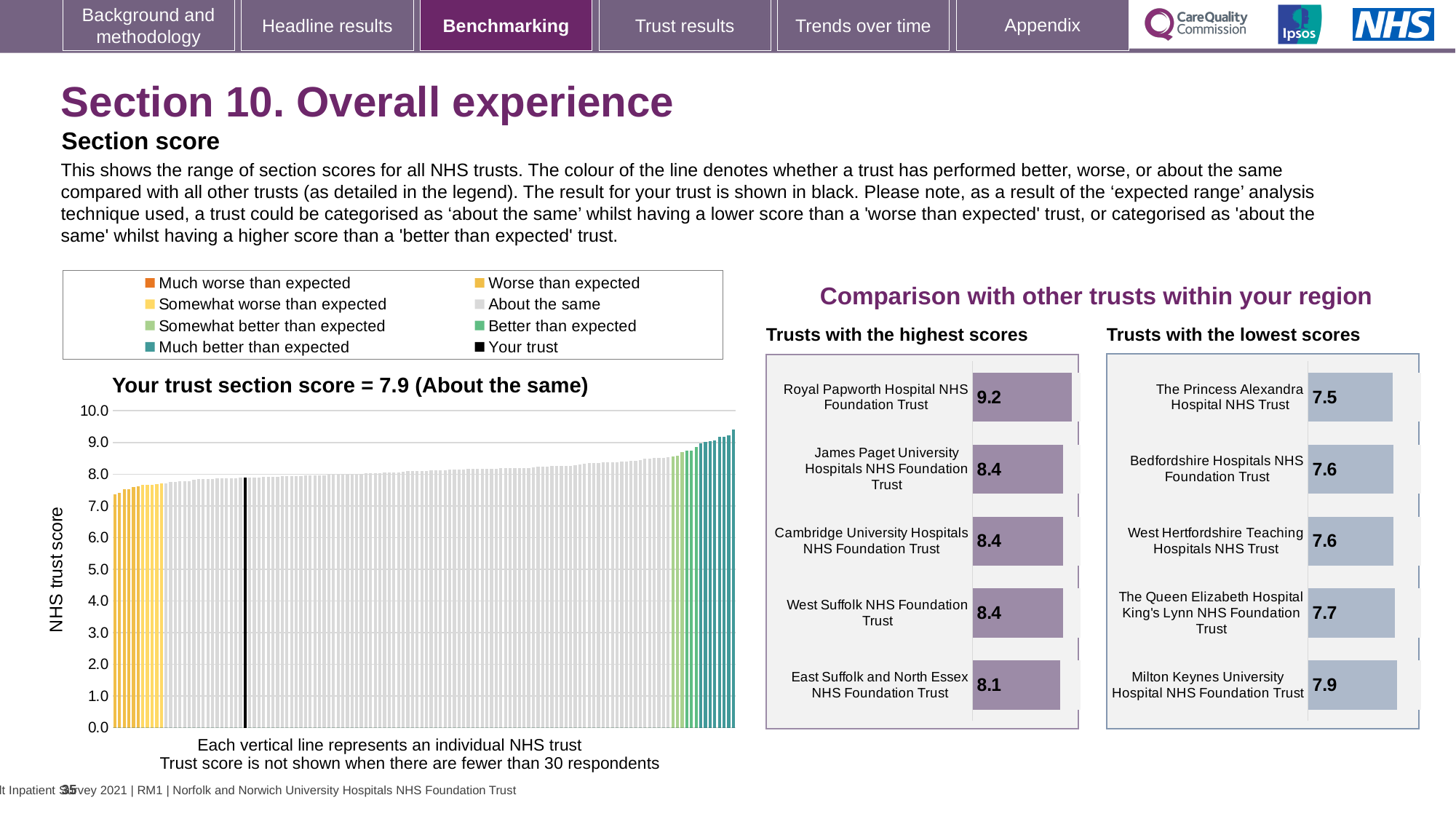
In the 'Trusts with the highest scores' chart, what is the score for Royal Papworth Hospital NHS Foundation Trust? 9.2 How many trusts are shown in the 'Trusts with the lowest scores' chart? 5 What is the y-axis label of the 'Your trust section score' chart? NHS trust score In the 'Trusts with the highest scores' chart, which trust has the lowest score? East Suffolk and North Essex NHS Foundation Trust In the 'Trusts with the lowest scores' chart, which trust has the lowest score? The Princess Alexandra Hospital NHS Trust In the 'Your trust section score' chart, do the trust scores rise or fall from left to right? rise In the 'Your trust section score' chart, is the value of the highest-scoring trust greater or less than 10.0? less In the 'Trusts with the highest scores' chart, what is the difference between the scores of Royal Papworth Hospital NHS Foundation Trust and East Suffolk and North Essex NHS Foundation Trust? 1.1 In the 'Your trust section score' chart, is the value of the lowest-scoring trust greater or less than 7.0? greater How many entries does the legend above the 'Your trust section score' chart list? 8 What kind of chart is the 'Your trust section score' chart? bar chart In the 'Your trust section score' chart, what is the section score for your trust? 7.9